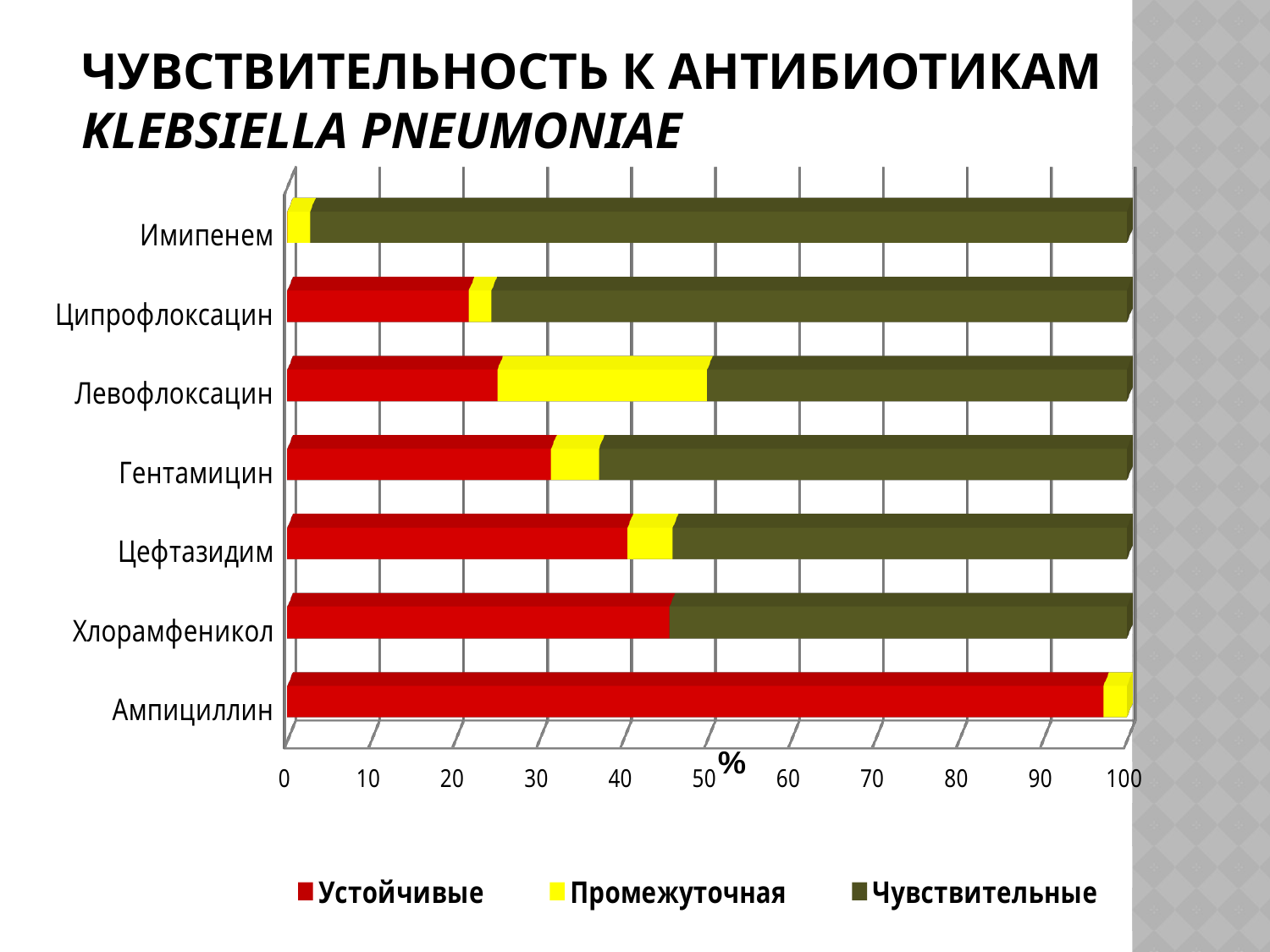
Is the Устойчивые value for Ампициллин greater or less than 90? greater How many antibiotics (categories) are shown on the chart? 7 Which has the larger Устойчивые (red) segment, Хлорамфеникол or Ципрофлоксацин? Хлорамфеникол Which antibiotic has the largest Устойчивые (red) segment? Ампициллин Is the Устойчивые value for Хлорамфеникол greater or less than 50? less Which antibiotic has the largest Промежуточная (yellow) segment? Левофлоксацин What kind of chart is shown on the slide? Stacked bar chart Which antibiotic has the largest Чувствительные (green) segment? Имипенем How many series does the legend list? 3 Is the Устойчивые value for Ципрофлоксацин greater or less than 30? less What unit label is shown on the horizontal axis? % Which series is shown in red according to the legend? Устойчивые